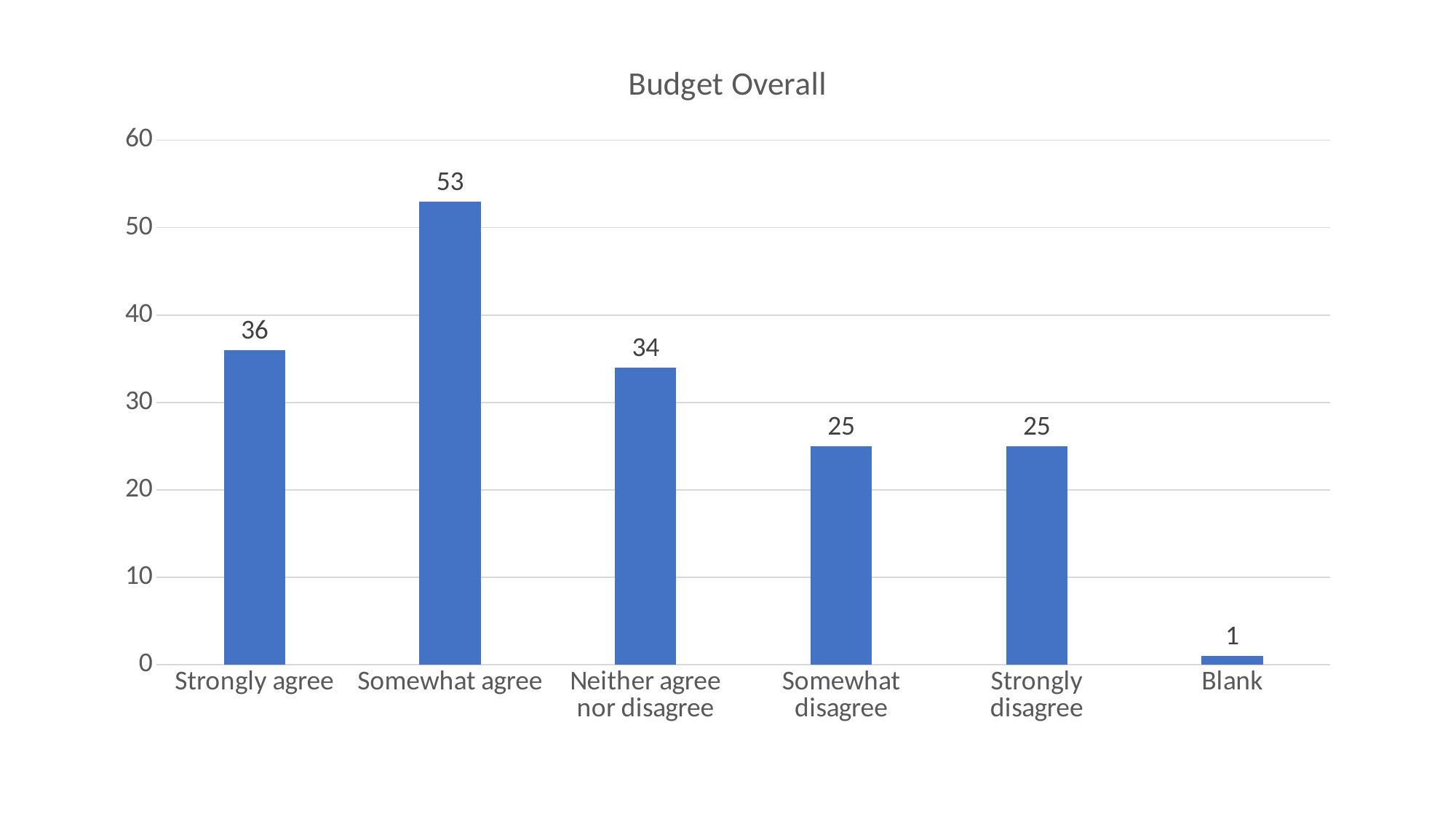
Which is larger, the value for Strongly agree or the value for Strongly disagree? Strongly agree What is the value for Neither agree nor disagree? 34 What is the value for Strongly agree? 36 What is the value for Somewhat agree? 53 How many categories are shown on the x axis? 6 What is the value for Blank? 1 Which category has the lowest value? Blank What is the title of the chart? Budget Overall What is the difference between the values for Neither agree nor disagree and Somewhat disagree? 9 Which category has the highest value? Somewhat agree Is the value for Somewhat agree greater or less than 50? greater What is the difference between the values for Somewhat agree and Strongly agree? 17